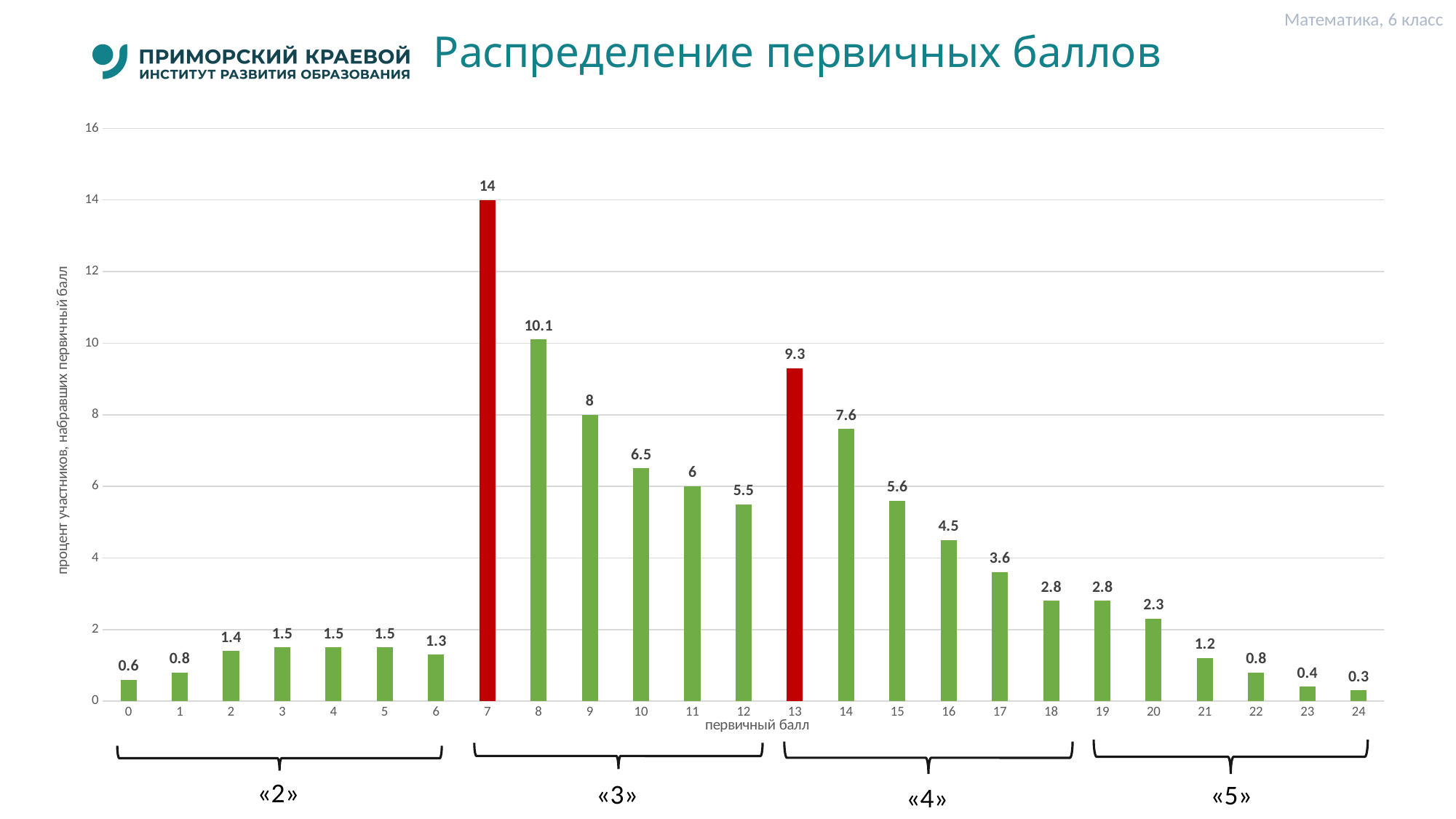
What kind of chart is shown on the slide? bar chart Which primary score has the lowest value? 24 What is the value for primary score 7? 14 Do the values rise or fall from primary score 13 to primary score 18? fall Which two bars are coloured red? 7 and 13 Which is larger, the value for primary score 14 or for primary score 15? 14 Is the value for primary score 10 greater or less than 6? greater What is the value for primary score 20? 2.3 What is the difference between the values for primary scores 8 and 9? 2.1 What is the value for primary score 13? 9.3 Which primary score has the highest value? 7 How many primary score categories are shown on the x axis? 25